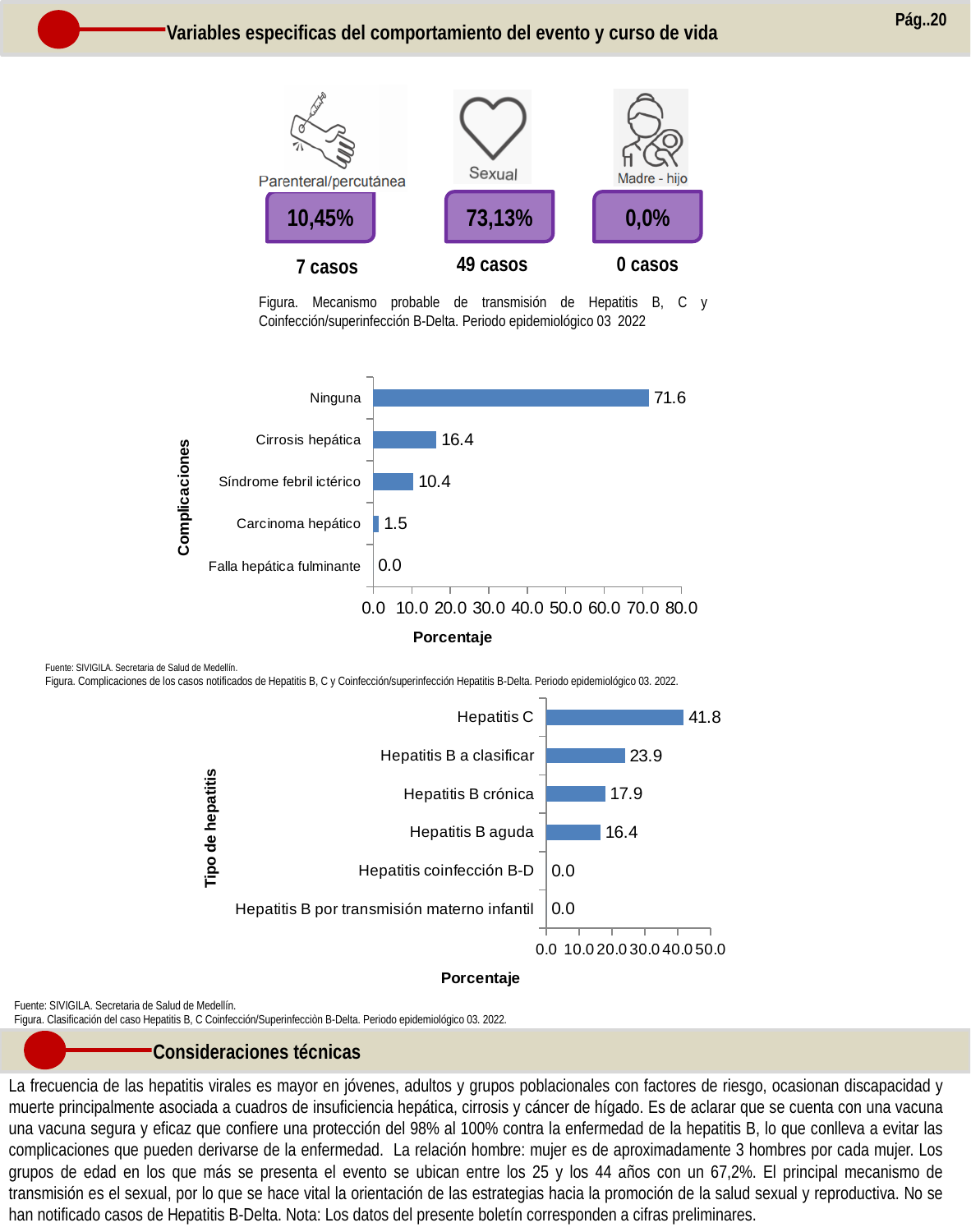
In the lower bar chart (Tipo de hepatitis), which is larger: Hepatitis B a clasificar or Hepatitis B aguda? Hepatitis B a clasificar In the lower bar chart (Tipo de hepatitis), what is the value for Hepatitis C? 41.8 In the upper bar chart (Complicaciones), what is the value for Ninguna? 71.6 In the lower bar chart (Tipo de hepatitis), how many categories are listed on the vertical axis? 6 In the upper bar chart (Complicaciones), what is the difference between Cirrosis hepática and Carcinoma hepático? 14.9 In the upper bar chart (Complicaciones), which complication has the lowest value? Falla hepática fulminante In the lower bar chart (Tipo de hepatitis), what is the value for Hepatitis B crónica? 17.9 In the upper bar chart (Complicaciones), what is the label of the horizontal axis? Porcentaje What kind of chart is the lower chart (Tipo de hepatitis)? Bar chart In the upper bar chart (Complicaciones), what is the value for Síndrome febril ictérico? 10.4 In the lower bar chart (Tipo de hepatitis), which type of hepatitis has the highest value? Hepatitis C In the upper bar chart (Complicaciones), how many complication categories are shown? 5